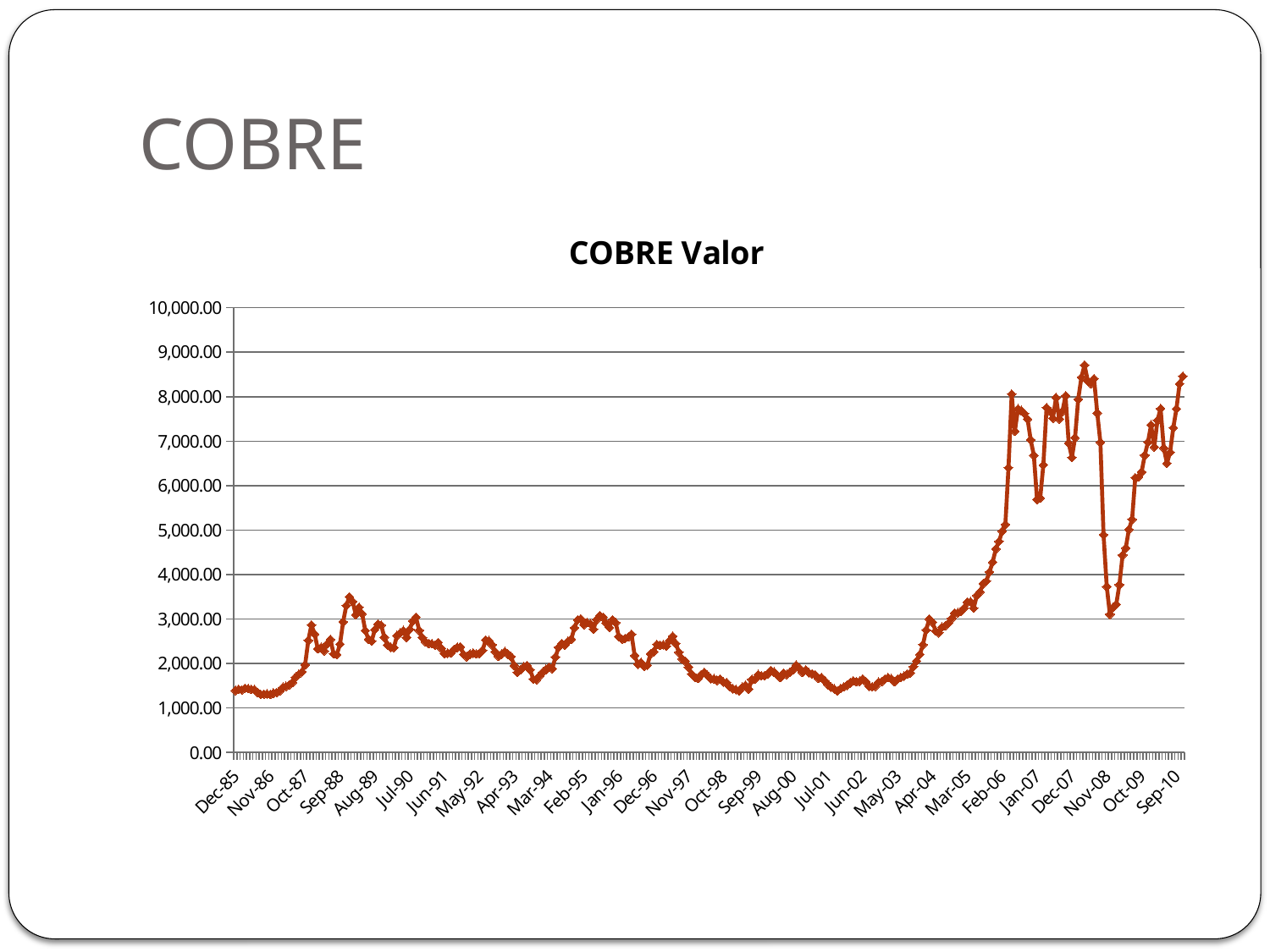
Is the value for Oct-98 greater or less than 2,000? less Is the highest value reached by the series greater or less than 9,000? less Is the value for Jul-01 greater or less than 2,000? less What is the highest value shown on the y axis? 10,000.00 Overall, do the values rise or fall from Dec-85 to Sep-10? rise What is the title of the chart? COBRE Valor Is the value for Dec-07 larger or smaller than the value for Dec-85? larger What kind of chart is shown on the slide? line chart